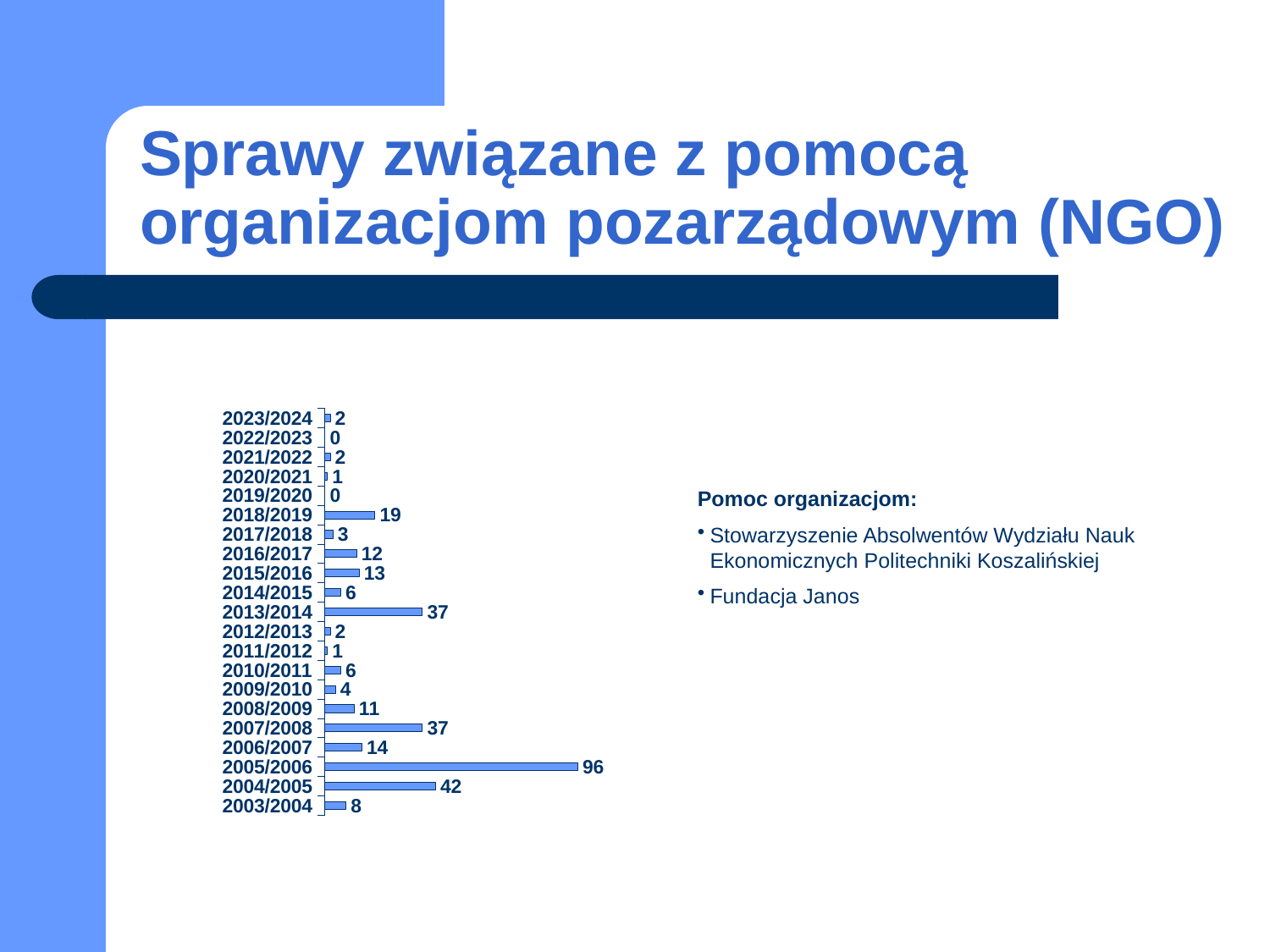
What is the difference between the values for 2005/2006 and 2004/2005? 54 What is the value for 2005/2006? 96 What kind of chart is shown on the slide? bar chart How many categories (academic years) does the chart show? 21 What is the value for 2004/2005? 42 Which is larger, the value for 2016/2017 or the value for 2015/2016? 2015/2016 What is the difference between the values for 2006/2007 and 2008/2009? 3 Which academic year has the highest value in the chart? 2005/2006 What is the value for 2013/2014? 37 Which academic years have a value of 0 in the chart? 2022/2023 and 2019/2020 What is the value for 2018/2019? 19 What is the value for 2003/2004? 8